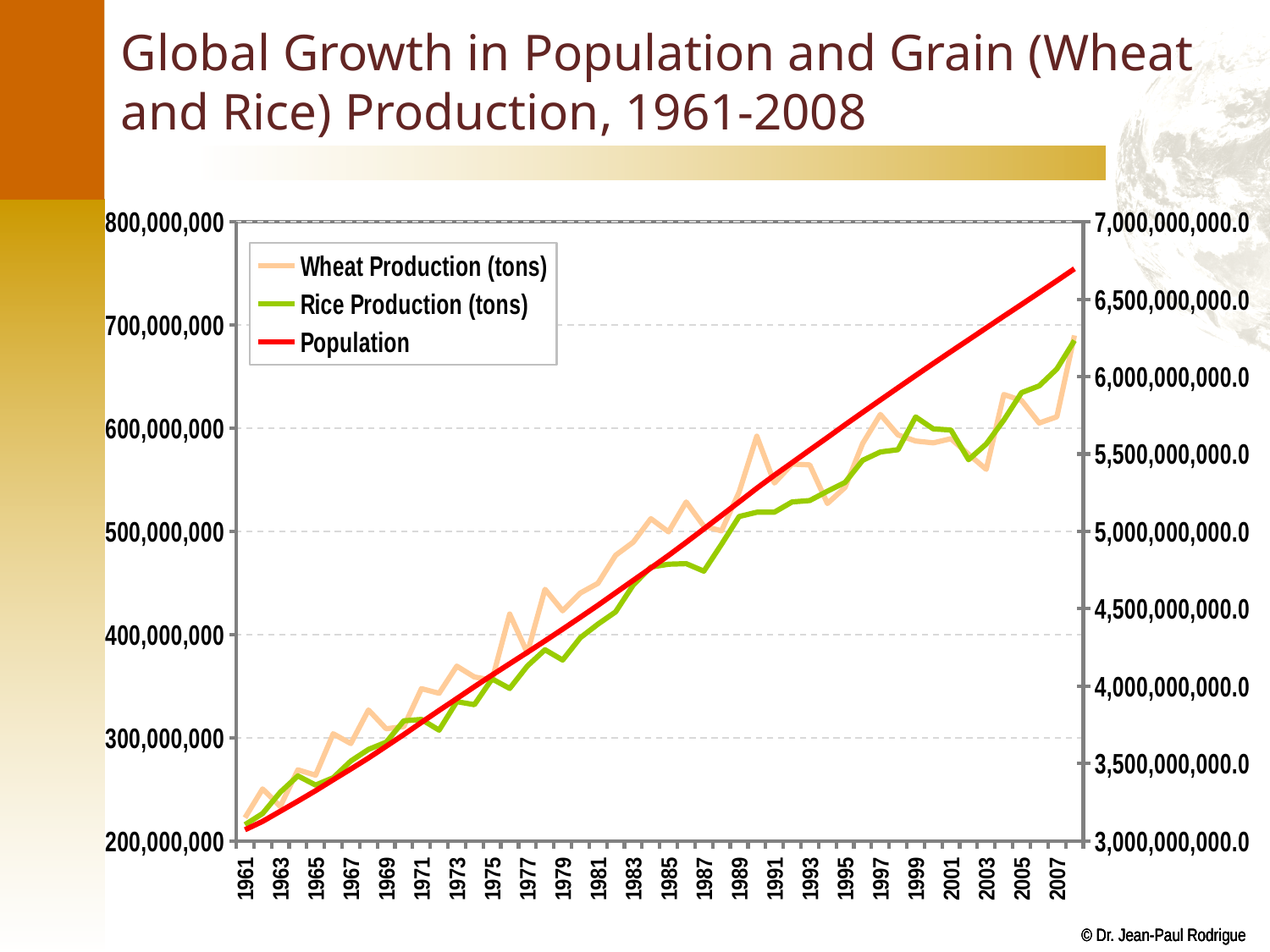
Overall, does Rice Production rise or fall across the years shown? rise Does the Population line rise or fall from 1961 to 2008? rise Is the value for Population in 1961 greater or less than 3,500,000,000.0? less Is the value for Rice Production in 1961 greater or less than 300,000,000? less What kind of chart is shown on the slide? line chart Is the value for Rice Production in 1987 greater or less than 500,000,000? less How many series does the legend list? 3 What is the title of the slide? Global Growth in Population and Grain (Wheat and Rice) Production, 1961-2008 What colour is the Population line in the legend? red In 1989, which is larger, Wheat Production or Rice Production? Wheat Production